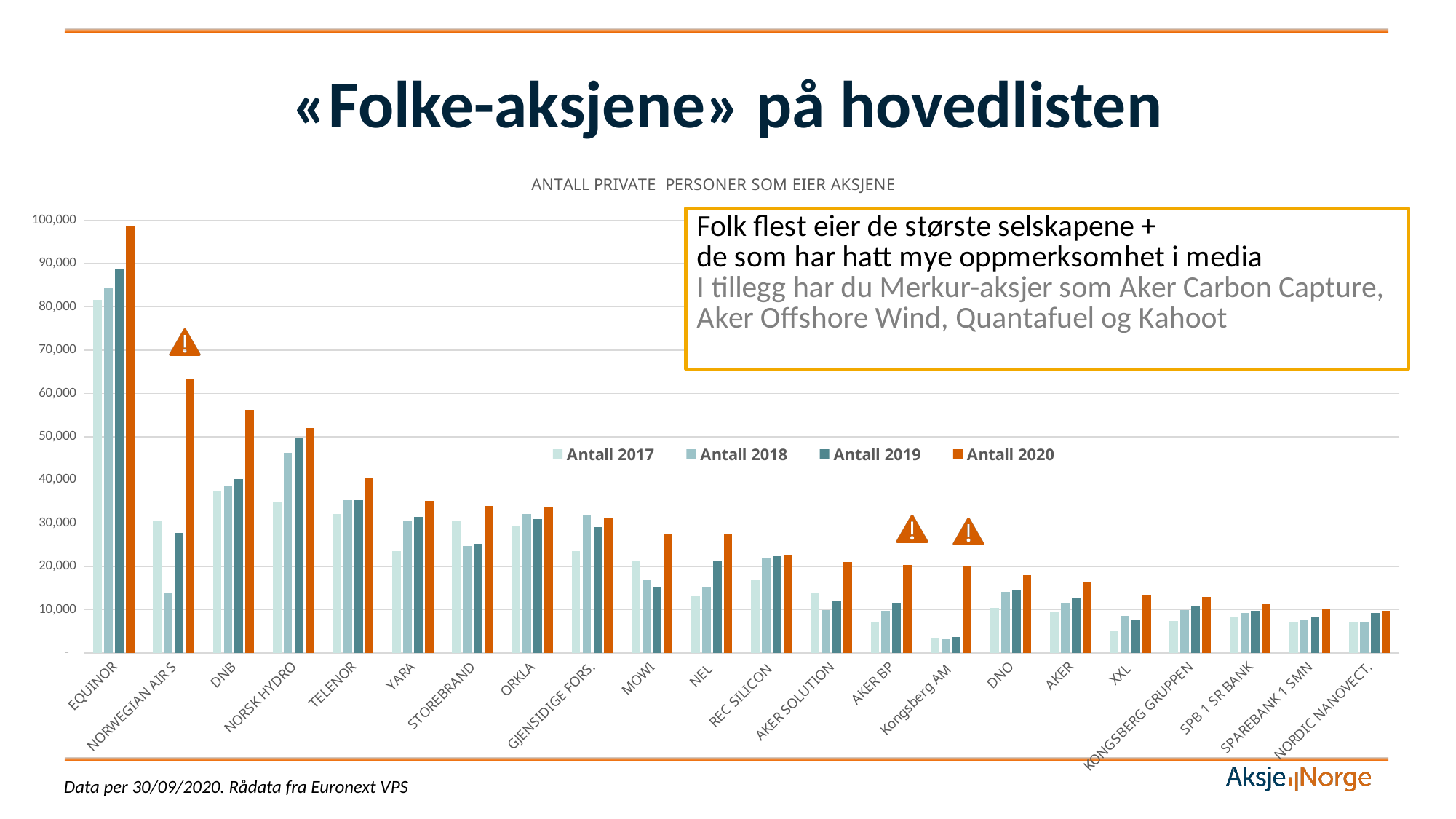
Is the Antall 2020 value for EQUINOR greater or less than 90,000? greater What is the title of the chart? ANTALL PRIVATE PERSONER SOM EIER AKSJENE Do the values for EQUINOR rise or fall from Antall 2017 to Antall 2020? Rise What kind of chart is shown on the slide? Bar chart For NORWEGIAN AIR S, which is larger: the Antall 2018 value or the Antall 2019 value? Antall 2019 Which company has the lowest value for Antall 2017? Kongsberg AM Is the Antall 2020 value for NORWEGIAN AIR S greater or less than 60,000? greater How many companies are shown along the x axis? 22 Which company has the highest value for Antall 2020? EQUINOR Is the Antall 2017 value for Kongsberg AM greater or less than 10,000? less How many series does the legend list? 4